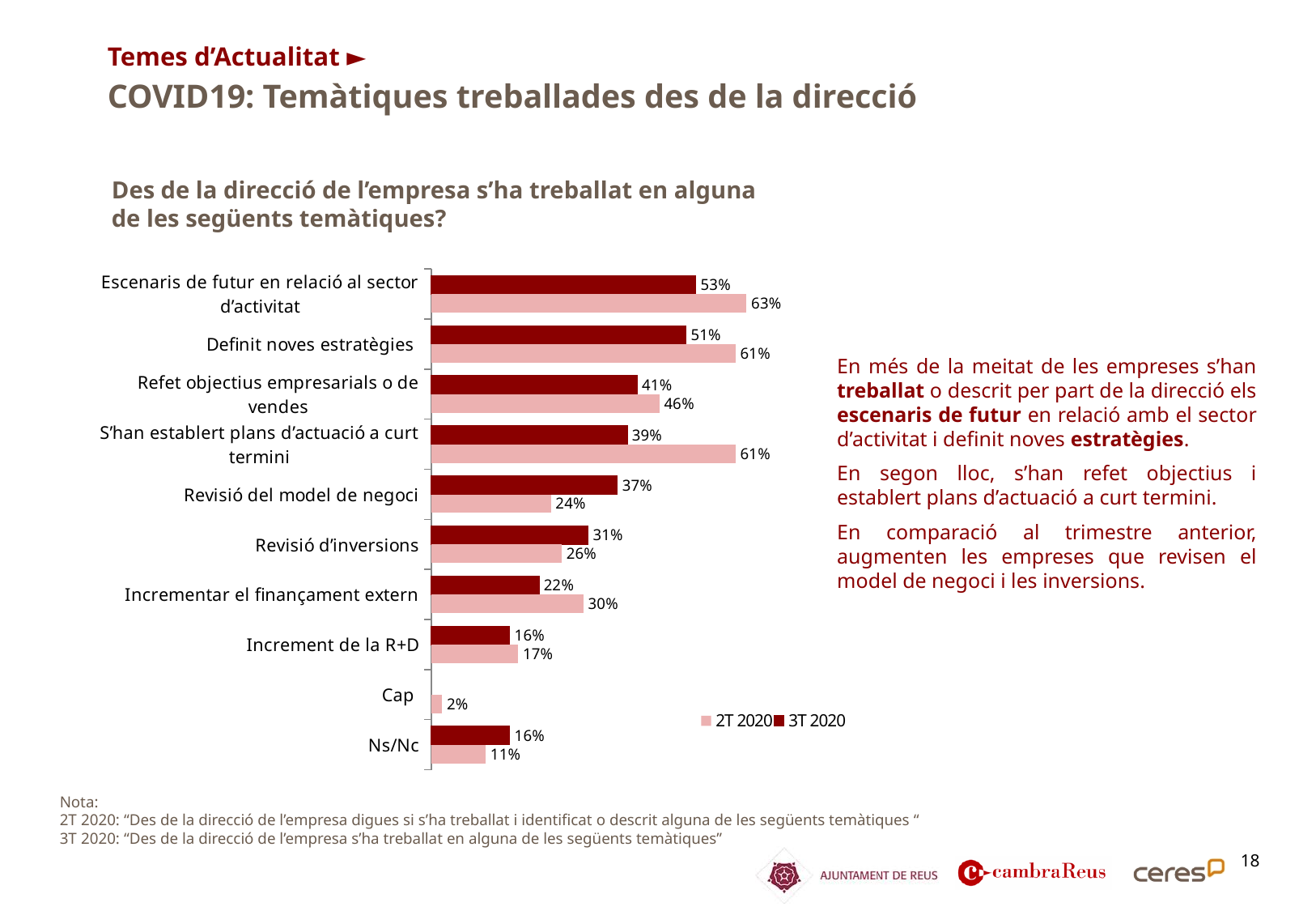
What kind of chart is shown on the slide? Bar chart How many categories are shown on the chart? 10 What is the 2T 2020 value for "Revisió del model de negoci"? 24% How many series does the legend list? 2 What is the 3T 2020 value for "Escenaris de futur en relació al sector d'activitat"? 53% What is the difference between the 2T 2020 and 3T 2020 values for "S'han establert plans d'actuació a curt termini"? 22 percentage points What is the 2T 2020 value for "S'han establert plans d'actuació a curt termini"? 61% Which series is shown in dark red? 3T 2020 For "Revisió d'inversions", which is larger: the 2T 2020 value or the 3T 2020 value? 3T 2020 For "Incrementar el finançament extern", which is larger: the 2T 2020 value or the 3T 2020 value? 2T 2020 Which category has the lowest 2T 2020 value? Cap Which category has the highest 3T 2020 value? Escenaris de futur en relació al sector d'activitat